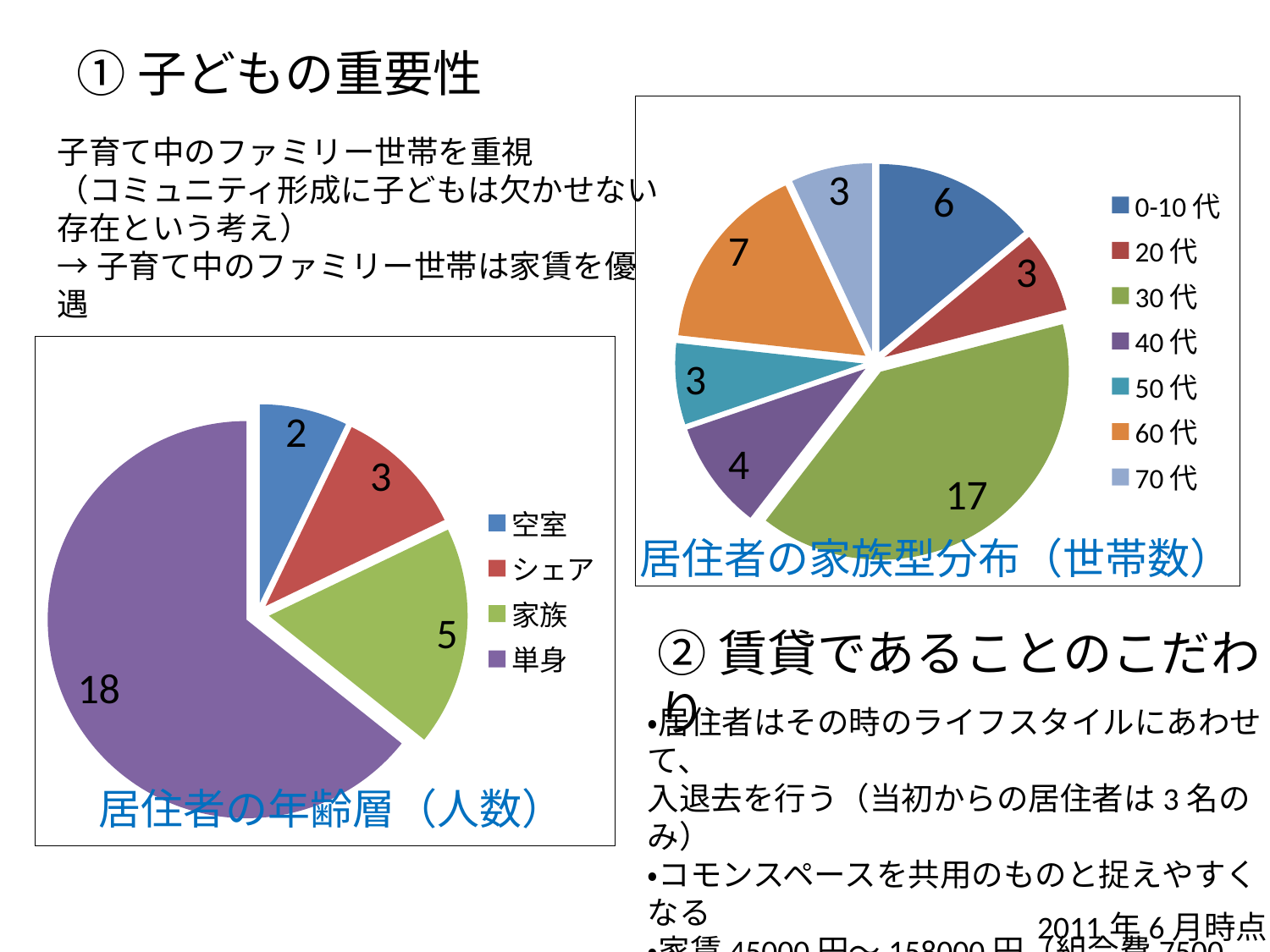
In the left pie chart (legend 空室, シェア, 家族, 単身), which category has the smallest slice? 空室 How many categories does the legend of the right pie chart list? 7 What type of chart is the chart on the left side of the slide? Pie chart In the right pie chart (legend 0-10代 to 70代), which is larger, the value for 0-10代 or the value for 40代? 0-10代 In the left pie chart (legend 空室, シェア, 家族, 単身), which category has the largest slice? 単身 In the left pie chart (legend 空室, シェア, 家族, 単身), what share of the total does 単身 represent? 64.3% In the right pie chart (legend 0-10代 to 70代), which category has the largest slice? 30代 In the left pie chart (legend 空室, シェア, 家族, 単身), what is the difference between the values for 家族 and シェア? 2 In the right pie chart (legend 0-10代 to 70代), what is the value for 60代? 7 How many slices does the left pie chart (legend 空室, シェア, 家族, 単身) have? 4 In the left pie chart (legend 空室, シェア, 家族, 単身), what is the value for 単身? 18 In the right pie chart (legend 0-10代 to 70代), what is the difference between the values for 30代 and 0-10代? 11